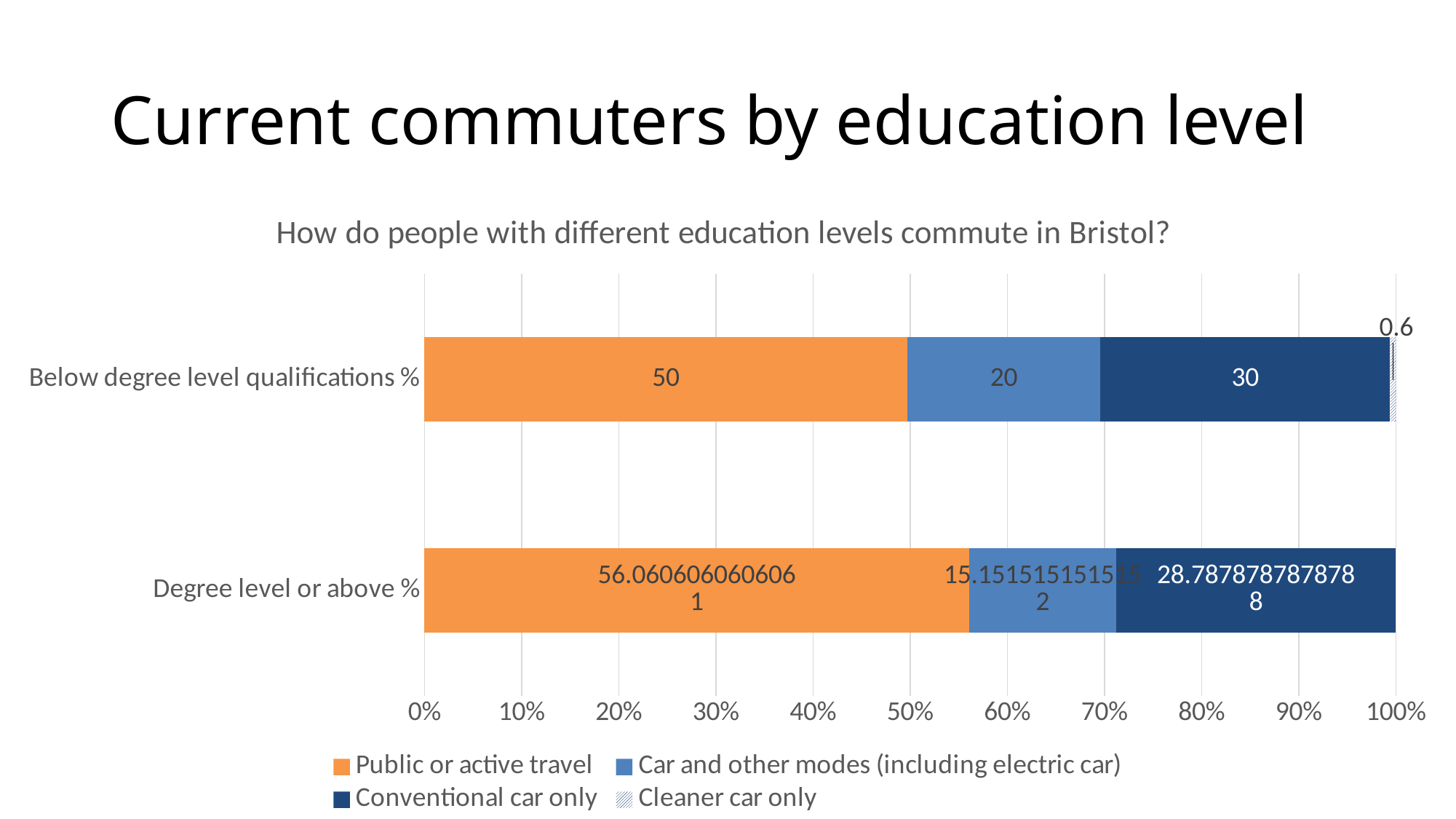
Which category has the larger Public or active travel value, Below degree level qualifications % or Degree level or above %? Degree level or above % What is the value for Car and other modes (including electric car) in the Below degree level qualifications % bar? 20 What is the value for Conventional car only in the Degree level or above % bar? 28.7878787878788 What is the value for Cleaner car only in the Below degree level qualifications % bar? 0.6 In the Below degree level qualifications % bar, what is the difference between Conventional car only and Car and other modes (including electric car)? 10 What kind of chart is shown on the slide? Stacked bar chart What is the value for Conventional car only in the Below degree level qualifications % bar? 30 Which series has the largest segment in the Below degree level qualifications % bar? Public or active travel How many education-level categories are plotted in the chart? 2 What is the title of the chart? How do people with different education levels commute in Bristol? What is the value for Public or active travel in the Below degree level qualifications % bar? 50 How many series does the legend list? 4